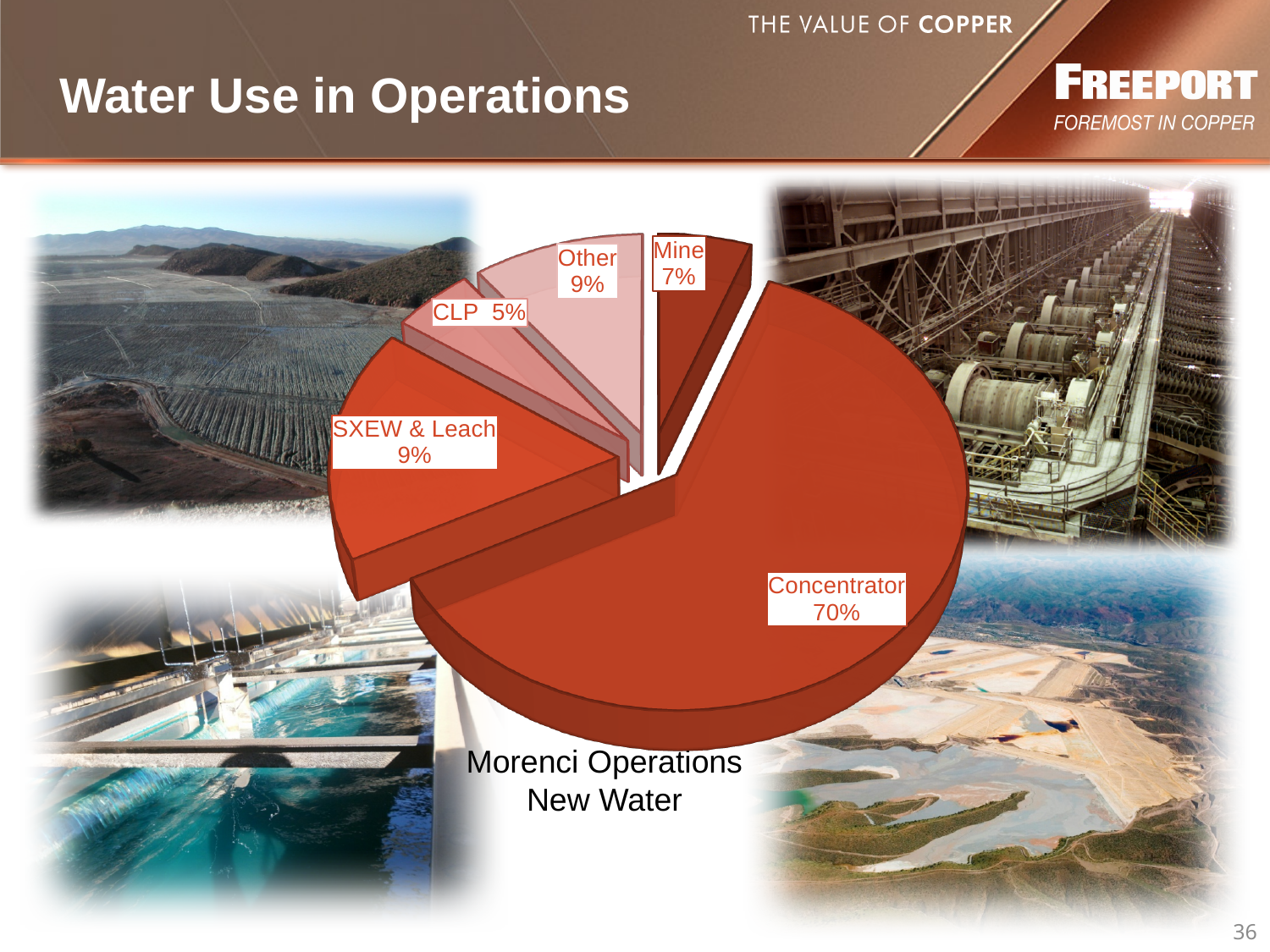
What share of new water is attributed to Other? 9% Which is larger, the Mine share or the CLP share? Mine Which category uses the largest share of new water? Concentrator What type of chart is shown on the slide? Pie chart What share of new water is used by SXEW & Leach? 9% What is the caption below the pie chart? Morenci Operations New Water How many percentage points larger is the Concentrator share than the Mine share? 63 Which category has the smallest share of new water? CLP What share of new water is attributed to CLP? 5% What share of new water is used by the Mine? 7% How many categories are shown in the pie chart? 5 What share of Morenci Operations new water is used by the Concentrator? 70%